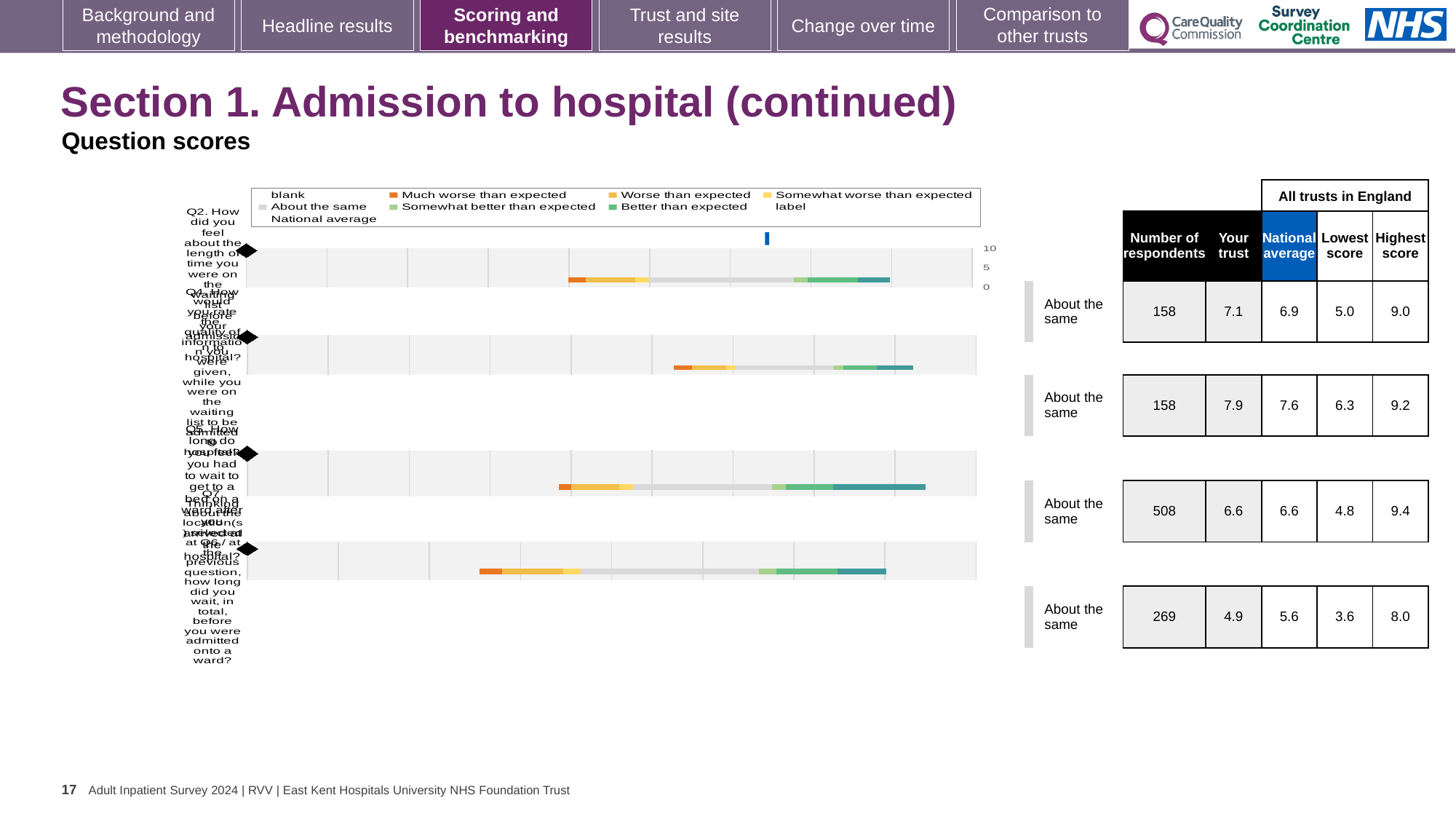
Is the 'Your trust' score for Q7 larger or smaller than the national average for Q7? smaller How many question bars are plotted in the chart? 4 Which question has the highest 'Your trust' score? Q4 What is the difference between the highest score (9.4) and the lowest score (4.8) for Q5? 4.6 Which question has the lowest 'Your trust' score? Q7 What colour does the legend use for 'Much worse than expected'? orange What is the 'Your trust' score for Q2 (how did you feel about the length of time on the waiting list)? 7.1 What kind of chart is shown on the slide? bar chart What is the lowest score across all trusts in England for Q7 (total wait before being admitted onto a ward)? 3.6 What is the national average score for Q4 (quality of information given while on the waiting list)? 7.6 What is the highest tick value shown on the chart's axis? 10 How many respondents answered Q5 (how long did you feel you had to wait to get to a bed on a ward)? 508